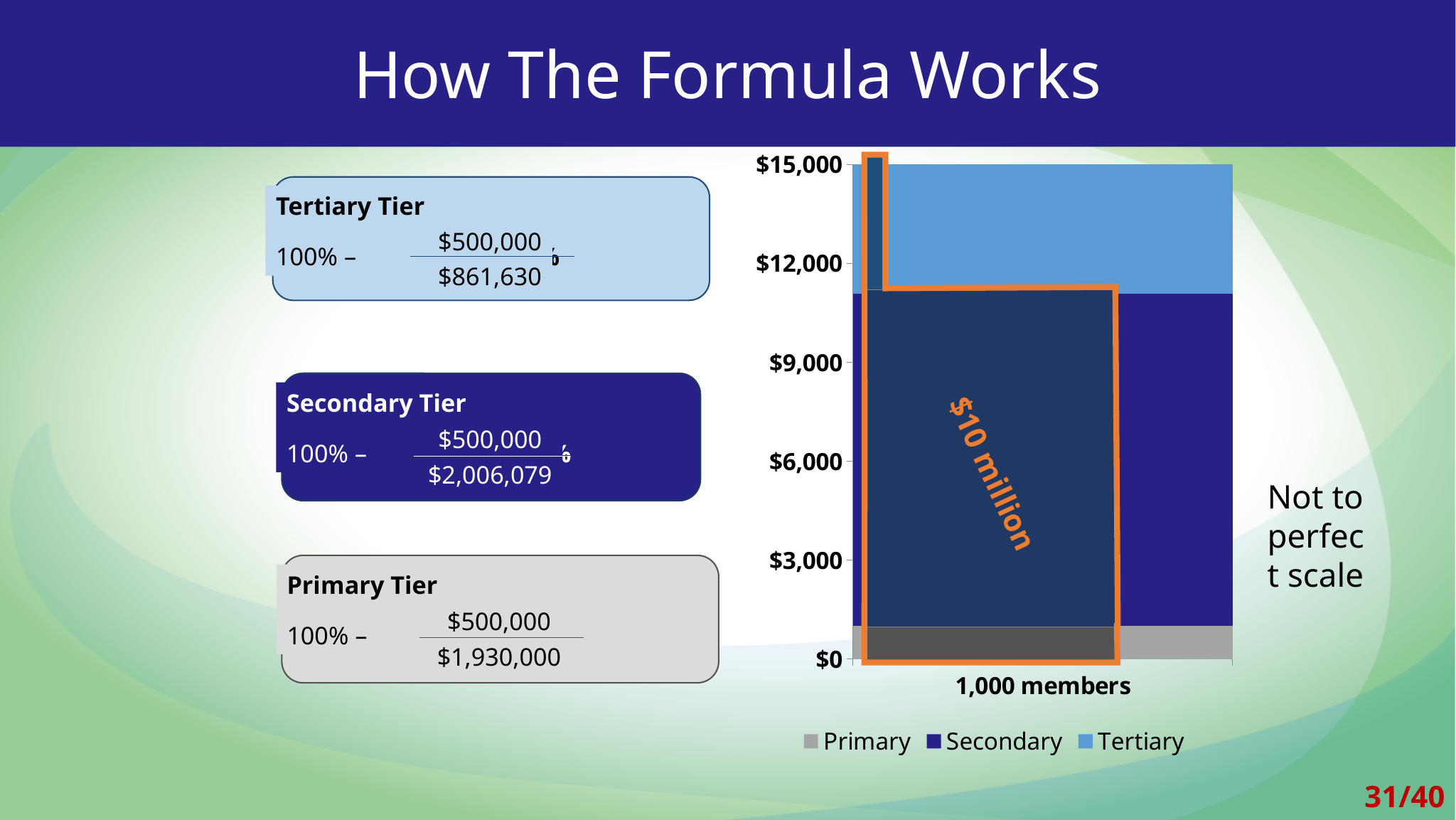
What is the category label on the x axis of the chart? 1,000 members Which series is shown in grey in the chart legend? Primary Which series in the chart has the smallest segment in the stacked bar? Primary Is the top of the stacked bar greater or less than $12,000? greater Which series in the chart has the largest segment in the stacked bar? Secondary What is the highest value shown on the y axis of the chart? $15,000 Which segment is larger in the stacked bar, Secondary or Tertiary? Secondary What kind of chart is shown on the slide? stacked bar chart How many categories are plotted on the x axis of the chart? 1 Is the Primary segment of the bar greater or less than $3,000? less Is the top of the Secondary segment greater or less than $9,000? greater How many series does the chart legend list? 3